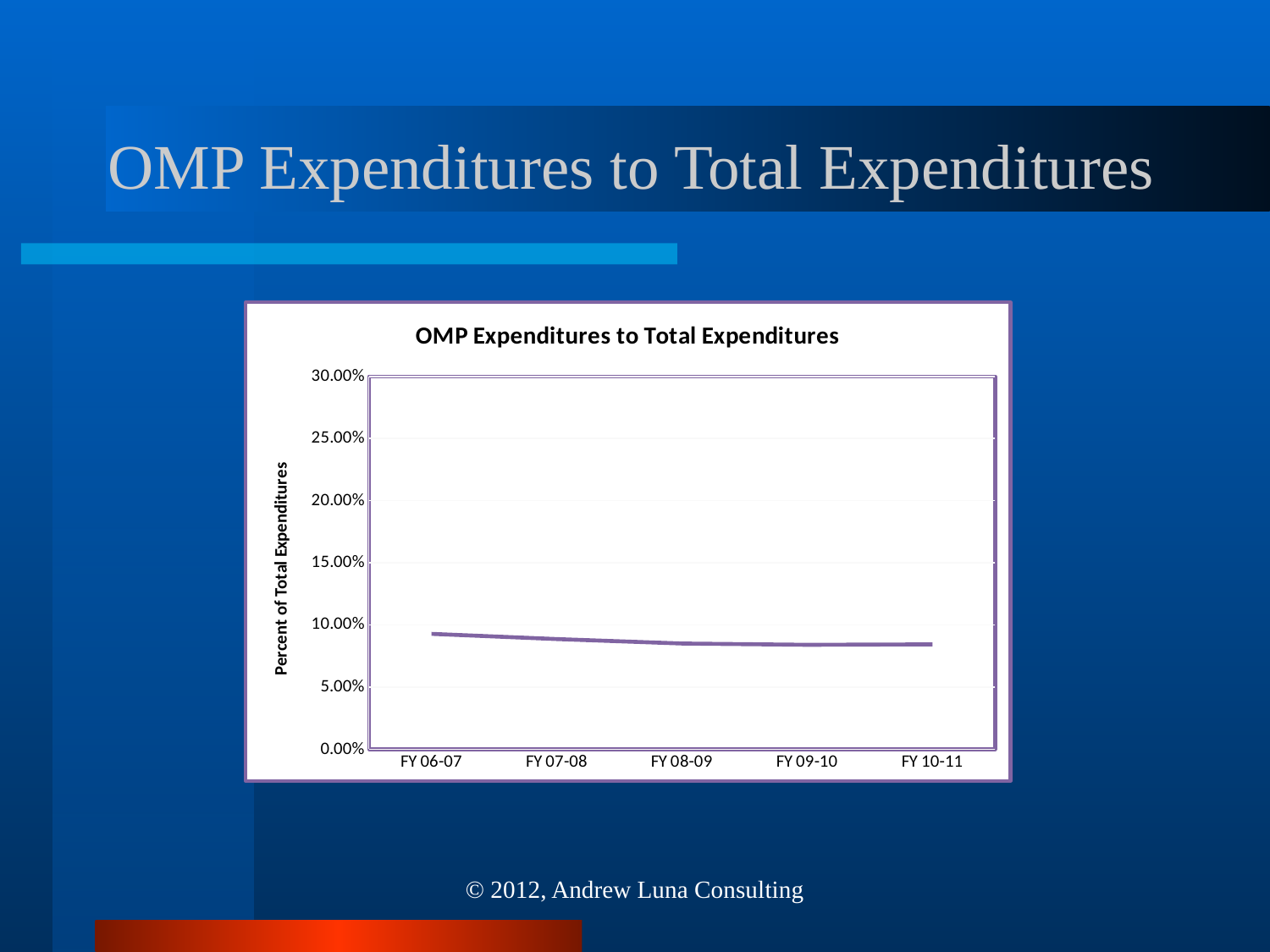
What is the title of the chart? OMP Expenditures to Total Expenditures How many fiscal years are plotted on the x axis of the chart? 5 Is the value for FY 10-11 greater or less than 5.00%? greater Which fiscal year has the highest percent of total expenditures? FY 06-07 What kind of chart is shown on the slide? line chart Do the values generally rise or fall from FY 06-07 to FY 10-11? fall Is the value for FY 08-09 greater or less than 15.00%? less What is the highest value shown on the y axis of the chart? 30.00% Which is larger, the value for FY 06-07 or the value for FY 10-11? FY 06-07 Is the value for FY 06-07 greater or less than 10.00%? less Which is larger, the value for FY 07-08 or the value for FY 09-10? FY 07-08 What is the label on the y axis of the chart? Percent of Total Expenditures